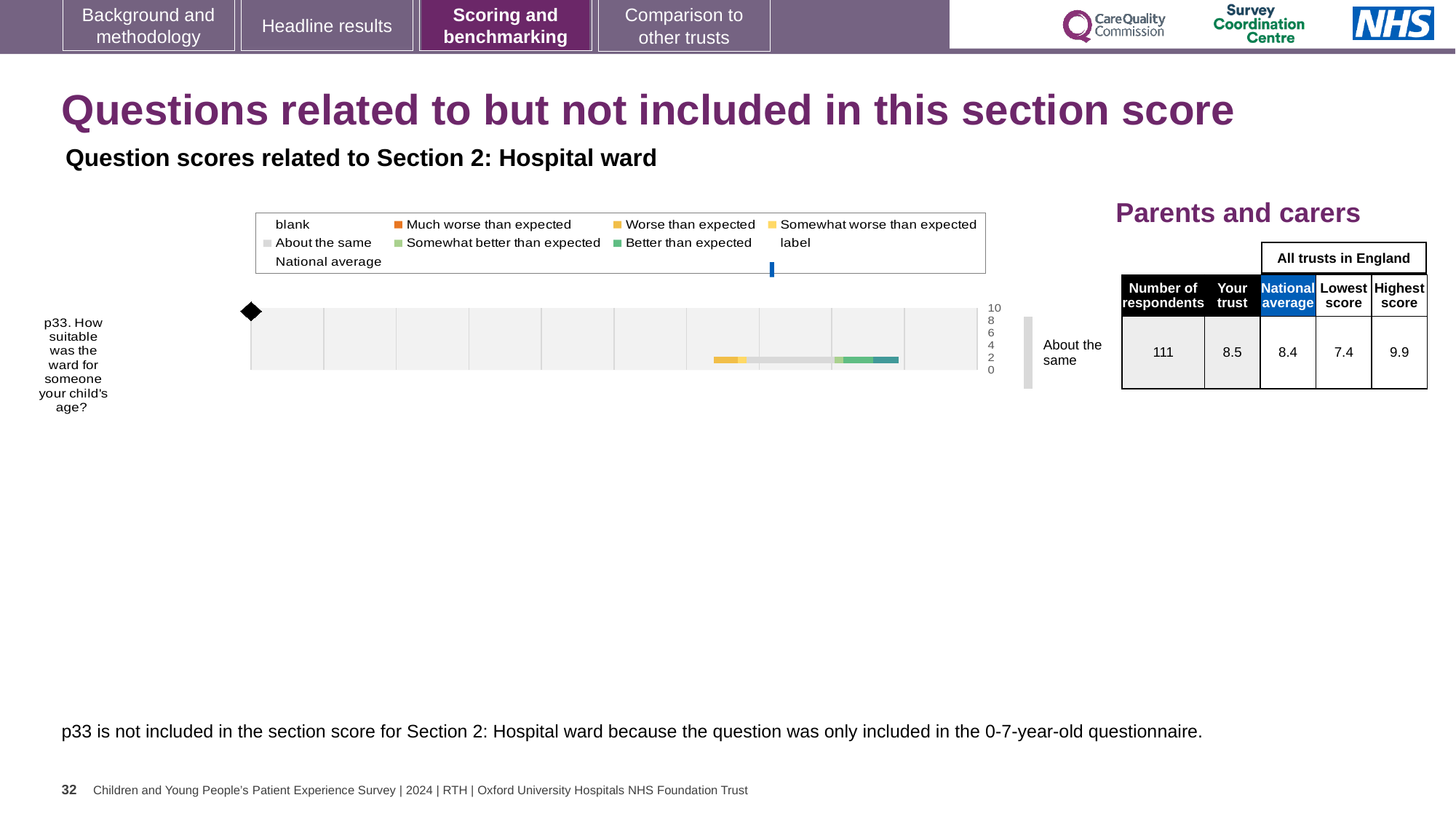
In the table beside the chart, which is larger for p33: the 'Your trust' score or the national average? Your trust Which question is plotted in the chart? p33. How suitable was the ward for someone your child's age? How many entries does the chart legend list? 9 In the table beside the chart, what is the national average score for p33? 8.4 In the table beside the chart, what is the difference between the highest score and the lowest score for p33? 2.5 In the table beside the chart, what is the highest score among all trusts in England for p33? 9.9 How many questions are plotted in the chart? 1 In the table beside the chart, how many respondents answered p33? 111 What benchmark label is shown to the right of the bar for p33? About the same In the table beside the chart, what is the 'Your trust' score for p33? 8.5 In the table beside the chart, what is the lowest score among all trusts in England for p33? 7.4 What type of chart is shown on the slide? bar chart